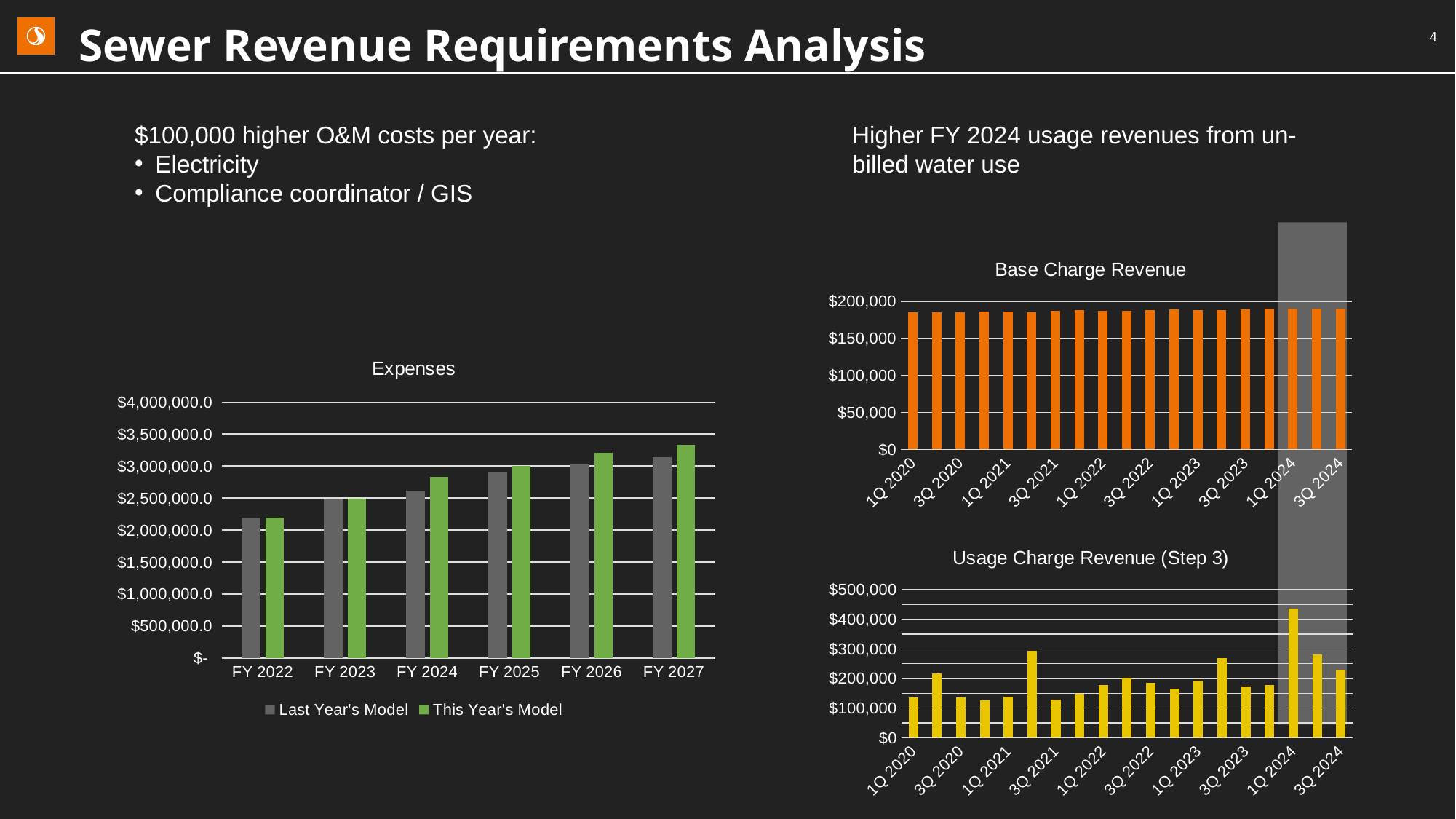
In the Base Charge Revenue chart, is the value for 1Q 2020 greater or less than $150,000? greater How many bars are plotted in the Base Charge Revenue chart? 19 In the Expenses chart, do the This Year's Model values rise or fall from FY 2022 to FY 2027? rise What kind of chart is the Expenses chart? bar chart In the Expenses chart, is the This Year's Model value for FY 2027 greater or less than $3,000,000.0? greater In the Expenses chart, which fiscal year has the highest This Year's Model value? FY 2027 How many fiscal years are shown on the x axis of the Expenses chart? 6 How many series does the legend of the Expenses chart list? 2 In the Expenses chart, is the Last Year's Model value for FY 2022 greater or less than $2,500,000.0? less In the Expenses chart, which series is shown in green? This Year's Model In the Usage Charge Revenue (Step 3) chart, which quarter has the highest value? 1Q 2024